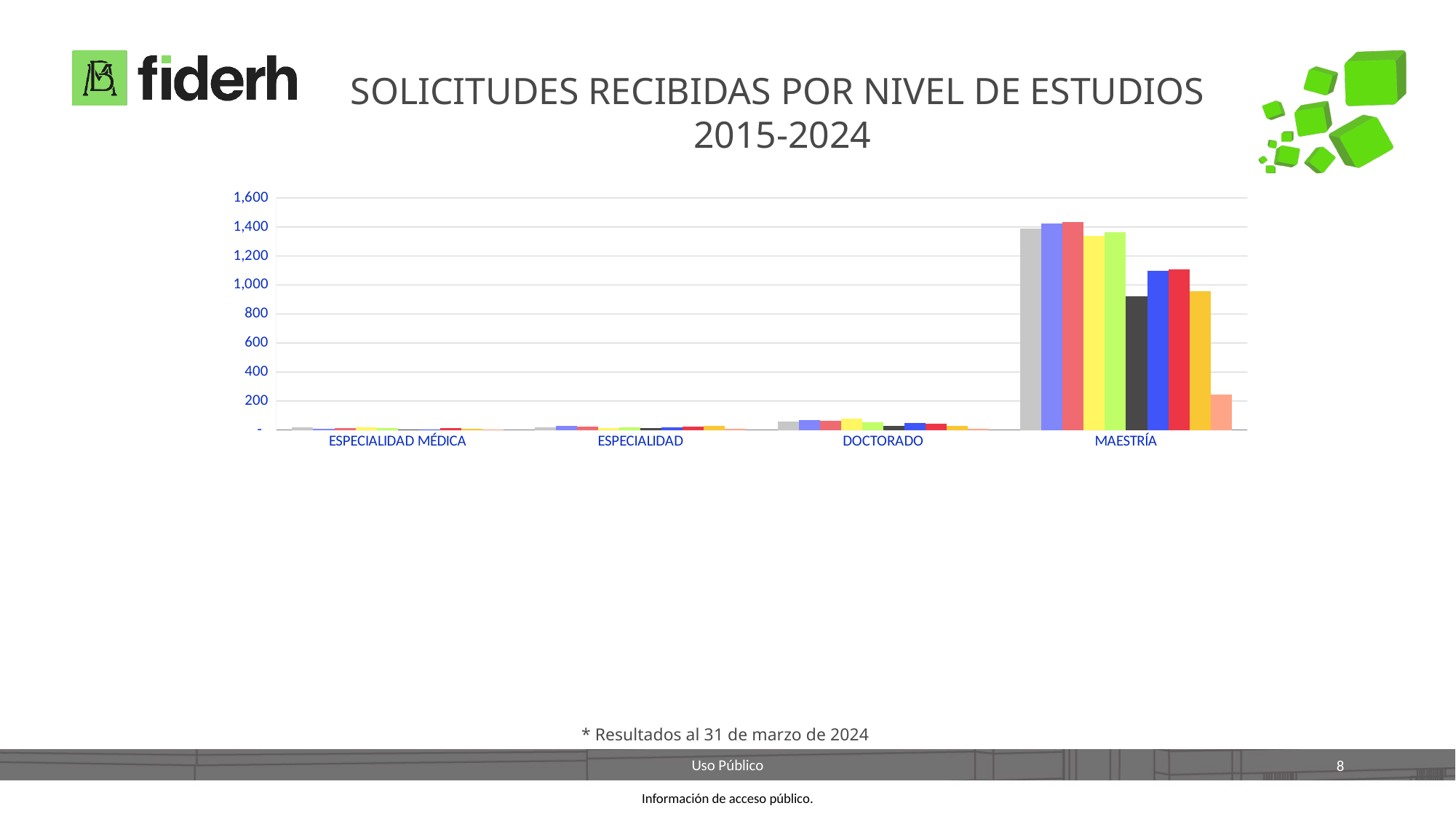
Which category has larger values, DOCTORADO or ESPECIALIDAD? DOCTORADO Which category has larger values, MAESTRÍA or DOCTORADO? MAESTRÍA What is the highest value shown on the chart's y axis? 1,600 Is the tallest bar for DOCTORADO greater or less than 200? less What kind of chart is shown on the slide? bar chart How many bars are plotted for the MAESTRÍA category? 10 What is the title of the slide containing the chart? SOLICITUDES RECIBIDAS POR NIVEL DE ESTUDIOS 2015-2024 Is the value of the dark grey bar for MAESTRÍA greater or less than 800? greater Is the value of the last (salmon) bar for MAESTRÍA greater or less than 400? less How many categories are shown on the x axis of the chart? 4 Which category has the highest values in the chart? MAESTRÍA